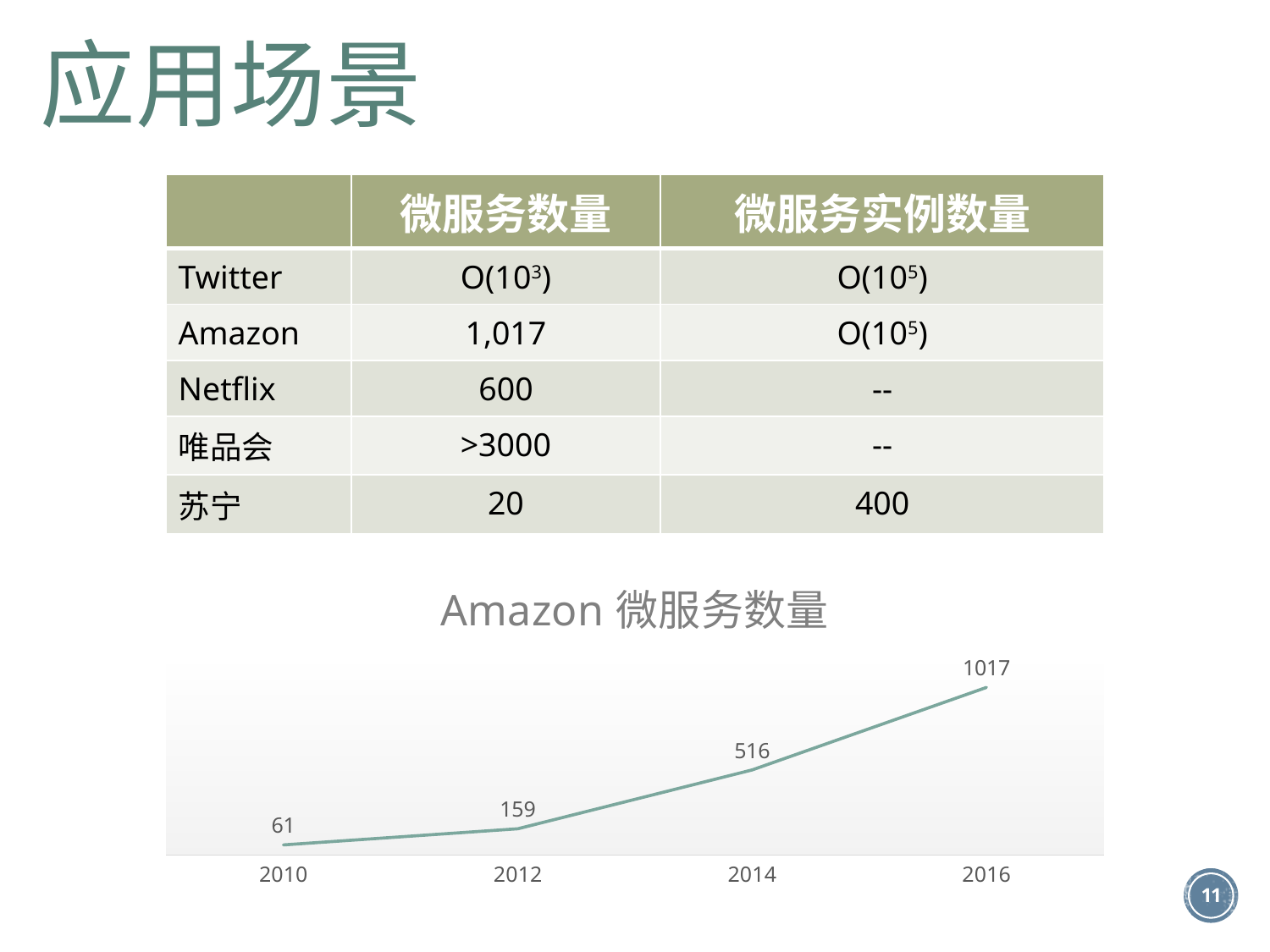
What is the value for 2012 in the Amazon 微服务数量 chart? 159 What type of chart is shown on the slide? line chart What is the value for 2014 in the Amazon 微服务数量 chart? 516 What is the value for 2010 in the Amazon 微服务数量 chart? 61 Which year has the highest value in the Amazon 微服务数量 chart? 2016 Which year has the lowest value in the Amazon 微服务数量 chart? 2010 What is the difference between the 2016 and 2014 values in the Amazon 微服务数量 chart? 501 Which is larger in the Amazon 微服务数量 chart, the value for 2012 or the value for 2014? 2014 How many data points are plotted in the Amazon 微服务数量 chart? 4 Do the values in the Amazon 微服务数量 chart rise or fall from 2010 to 2016? rise What is the value for 2016 in the Amazon 微服务数量 chart? 1017 What is the title of the chart on the slide? Amazon 微服务数量